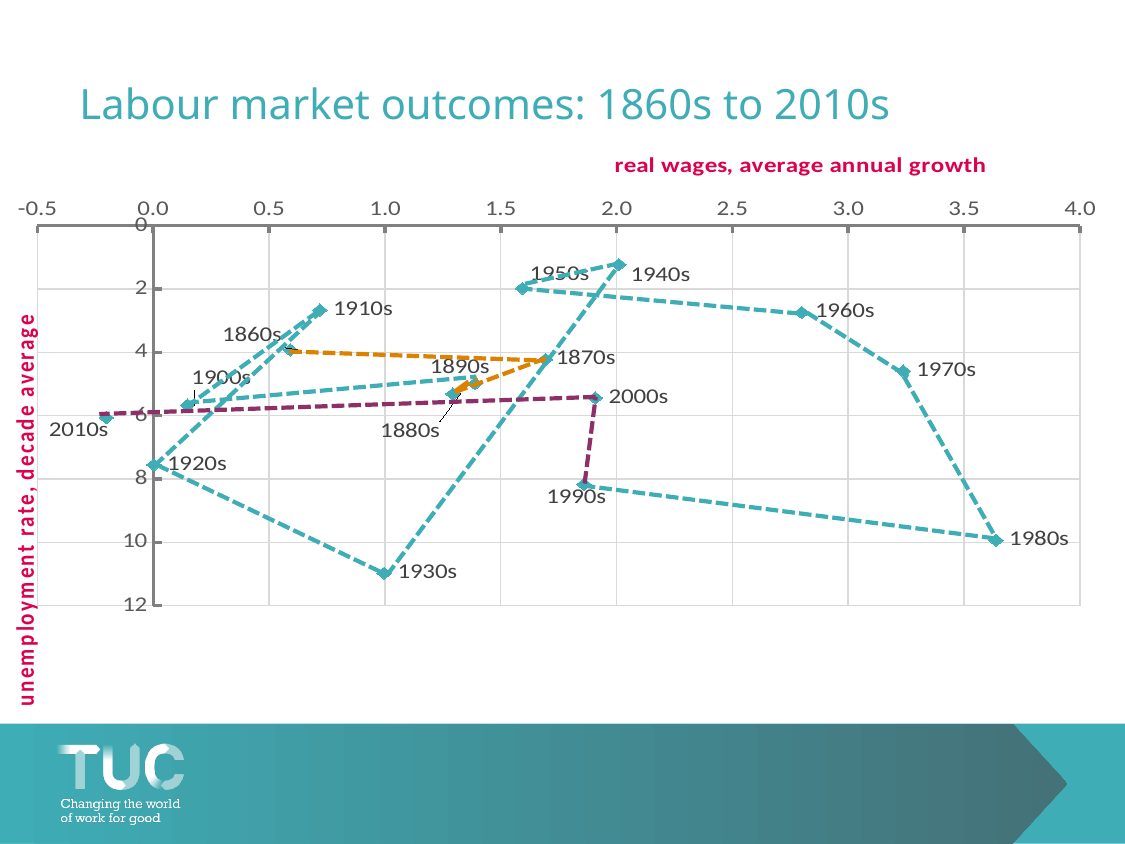
What is the title of the chart? Labour market outcomes: 1860s to 2010s Which decade has the highest unemployment rate on the chart? 1930s Is the real wages average annual growth for the 2010s greater or less than 0.0? less Which decade has the highest real wages average annual growth? 1980s What does the vertical axis of the chart measure? unemployment rate, decade average What kind of chart is shown on the slide? scatter chart with connected points Which decade has the higher unemployment rate, the 1910s or the 1920s? 1920s Which decade has the lowest real wages average annual growth? 2010s How many decades are plotted as points on the chart? 16 Is the unemployment rate for the 1930s greater or less than 10? greater Is the real wages average annual growth for the 1970s greater or less than 3.0? greater Which decade has the lowest unemployment rate on the chart? 1940s